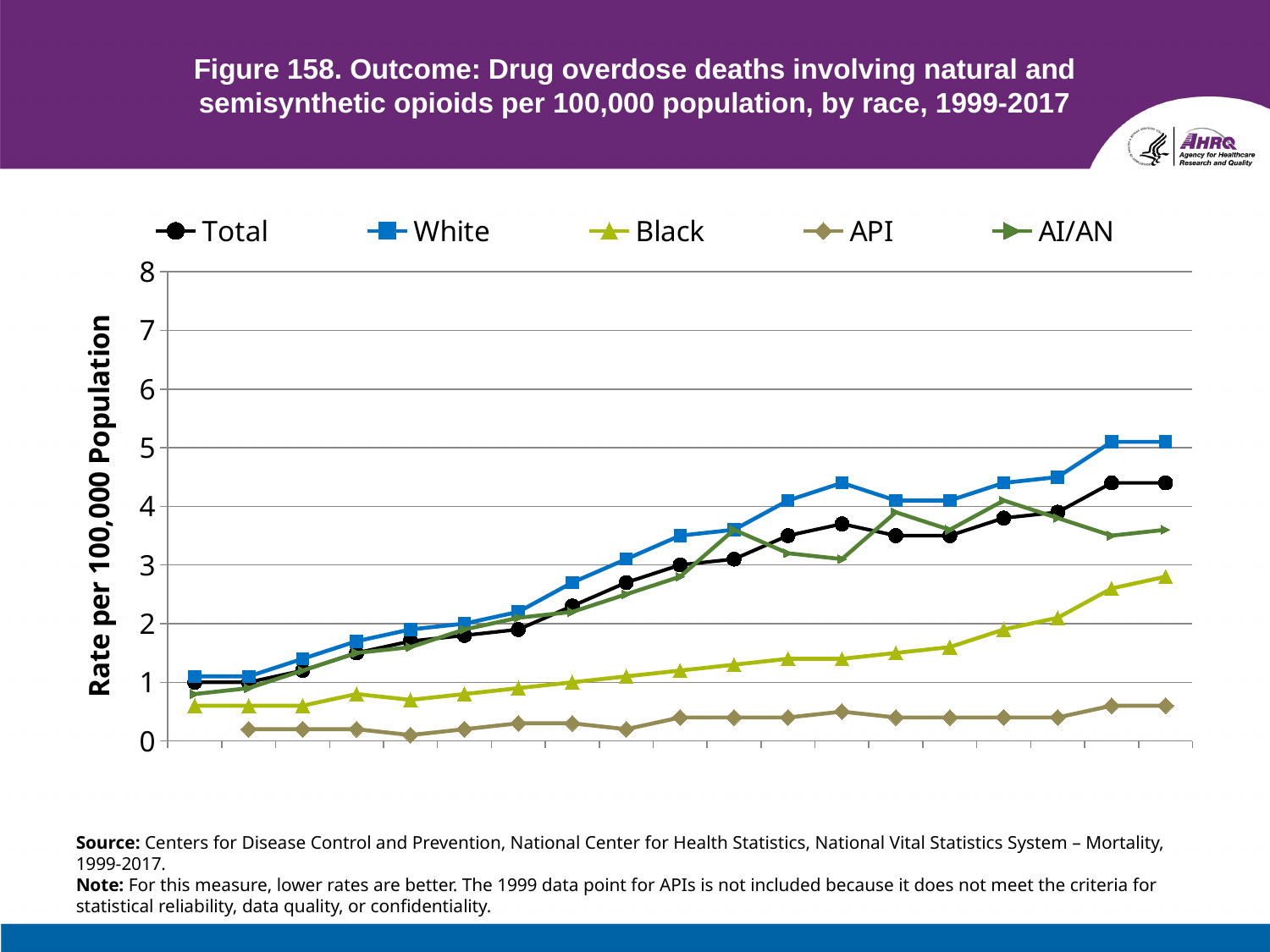
Is the value for API at the final data point (2017) greater or less than 1? less What is the label on the vertical axis? Rate per 100,000 Population Does the White series generally rise or fall from 1999 to 2017? rise Is the value for Total at the final data point (2017) greater or less than 4? greater How many series does the legend list? 5 Which series has the lowest value at the final data point (2017)? API Is the value for Black at the final data point (2017) greater or less than 3? less How many data points does the Total series have? 19 What kind of chart is shown on the slide? line chart Which series has the highest value at the final data point (2017)? White At the final data point (2017), which is larger, the value for Black or the value for API? Black